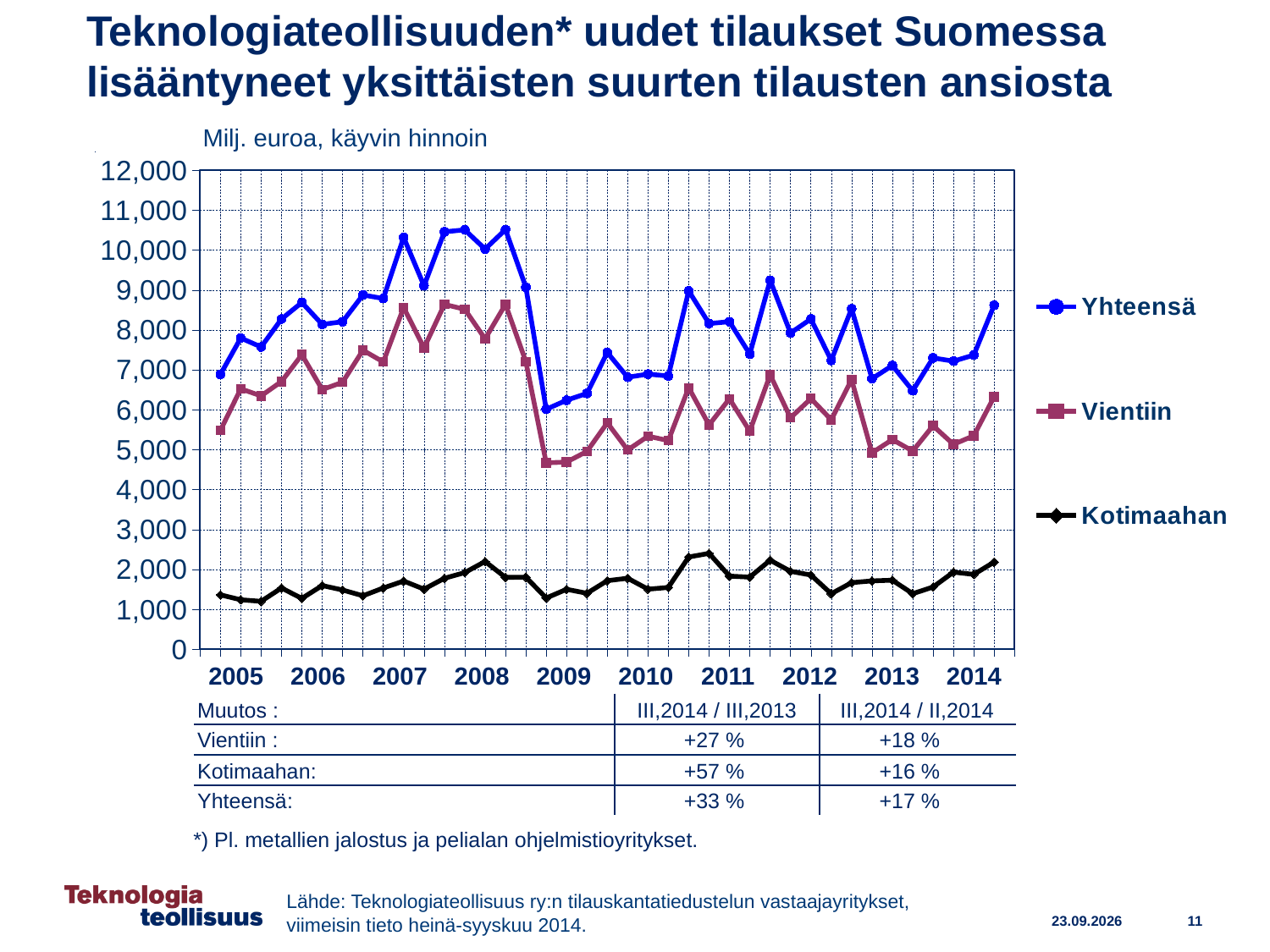
What are the three series named in the legend? Yhteensä, Vientiin, Kotimaahan Is the last plotted value for Yhteensä in 2014 greater or less than 8,000? greater Does the Yhteensä series rise or fall from its 2008 peak into 2009? fall Which is larger in 2010, the value for Vientiin or the value for Kotimaahan? Vientiin Which series has the highest values throughout the chart? Yhteensä How many series does the legend list? 3 What kind of chart is shown on the slide? line chart What unit is stated above the chart for the values? Milj. euroa, käyvin hinnoin Which series has the lowest values throughout the chart? Kotimaahan Is the value for Vientiin at the start of 2009 greater or less than 5,000? less Is the highest value for Kotimaahan in 2011 greater or less than 2,000? greater